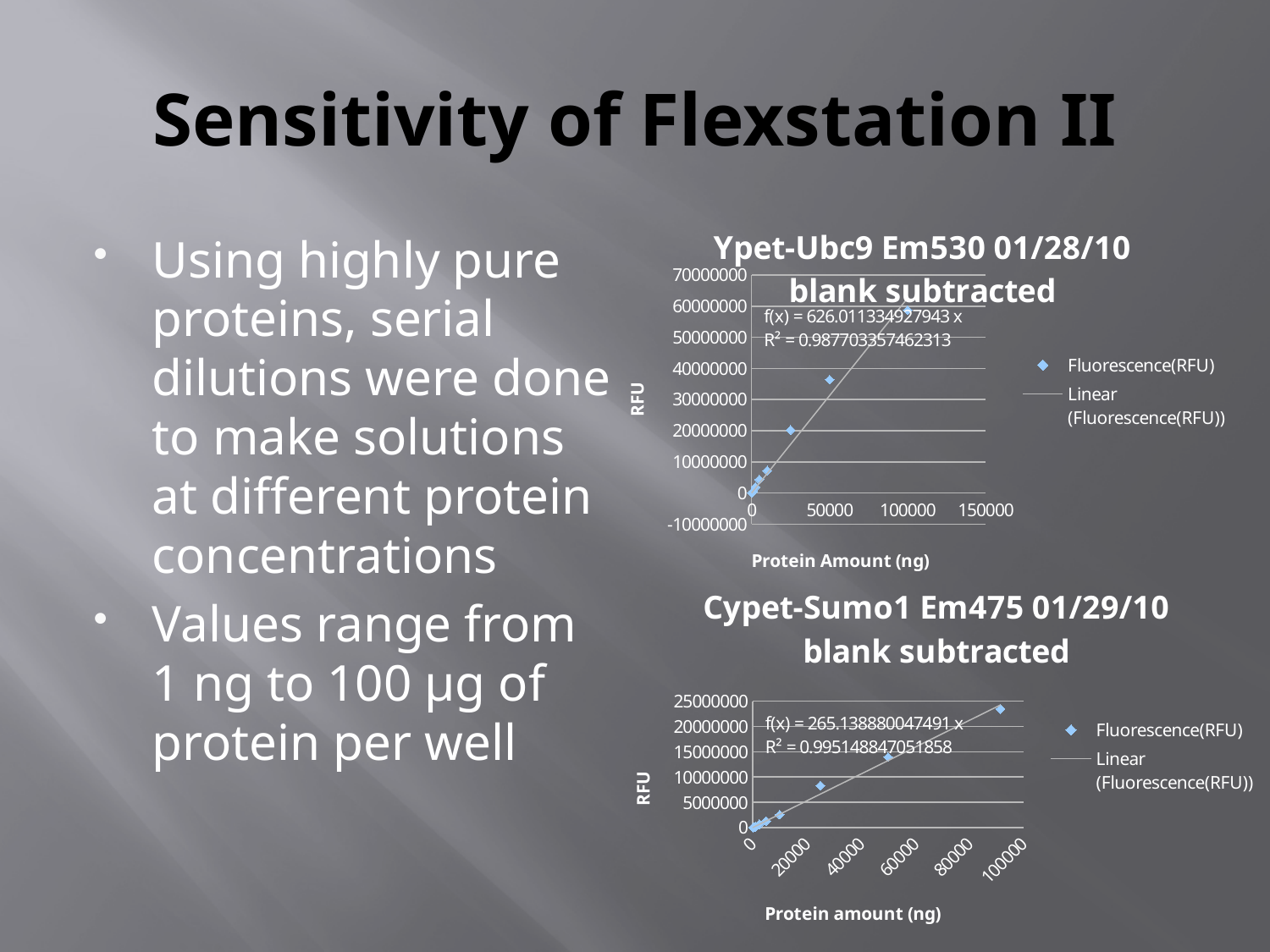
In the bottom chart (Cypet-Sumo1), how many entries does the legend list? 2 What kind of chart is the top chart titled "Ypet-Ubc9 Em530 01/28/10 blank subtracted"? scatter chart In the bottom chart (Cypet-Sumo1), do the fluorescence values rise or fall as protein amount increases? rise In the top chart (Ypet-Ubc9), how many entries does the legend list? 2 What is the R² value shown on the top chart (Ypet-Ubc9)? 0.987703357462313 In the bottom chart (Cypet-Sumo1), is the fluorescence value at about 25000 ng greater or less than 10000000? less What kind of chart is the bottom chart titled "Cypet-Sumo1 Em475 01/29/10 blank subtracted"? scatter chart In the bottom chart (Cypet-Sumo1), is the fluorescence value at the highest protein amount (around 100000 ng) greater or less than 20000000? greater What is the trendline equation shown on the bottom chart (Cypet-Sumo1)? f(x) = 265.138880047491 x In the top chart (Ypet-Ubc9), do the fluorescence values rise or fall as protein amount increases? rise In the top chart (Ypet-Ubc9), is the fluorescence value at the highest protein amount (around 100000 ng) greater or less than 50000000? greater